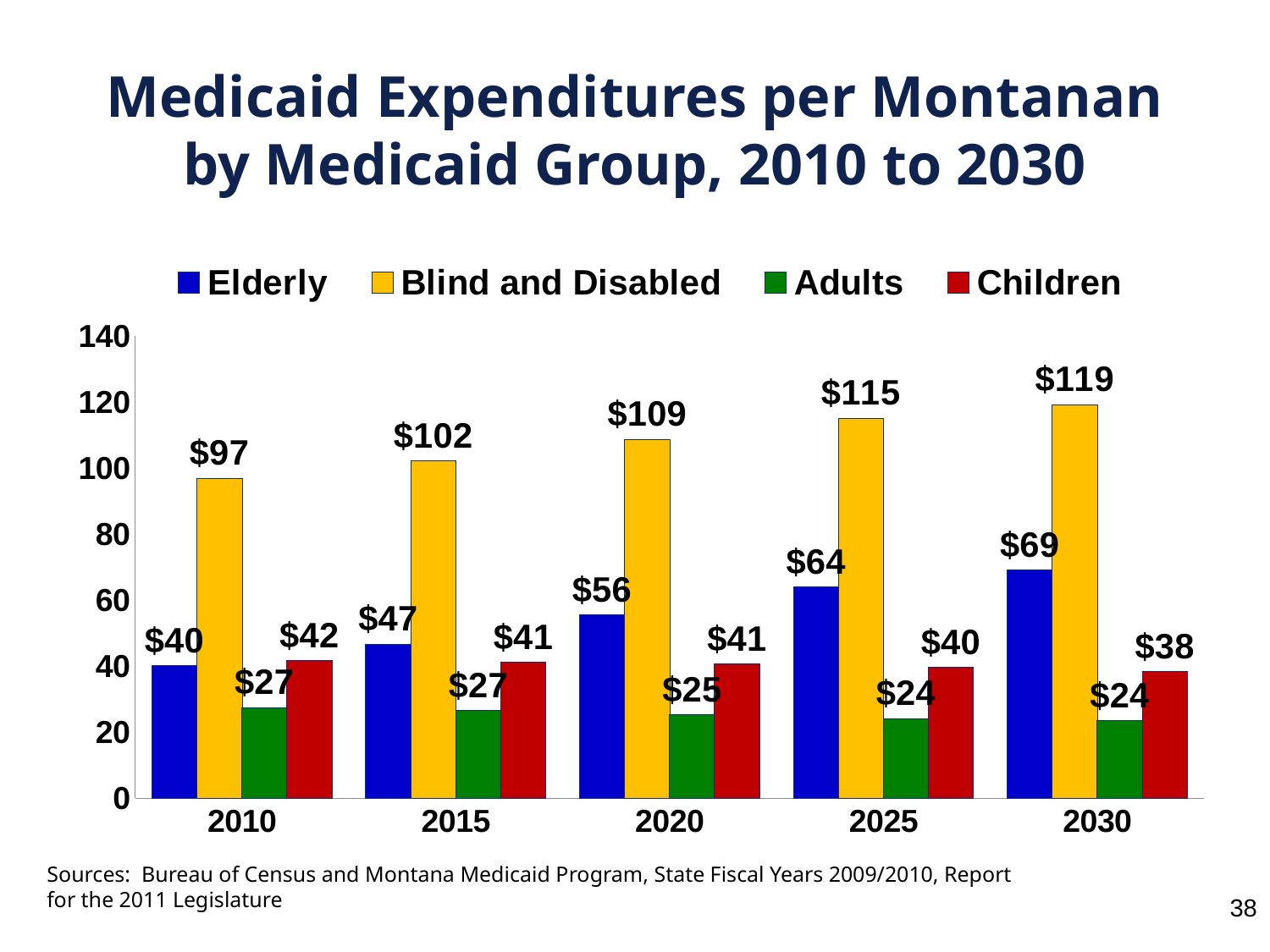
What is the Medicaid expenditure per Montanan for the Blind and Disabled group in 2020? $109 How many years are shown on the x axis? 5 What kind of chart is shown on the slide? Bar chart What is the difference between the Blind and Disabled value in 2030 and in 2010? $22 What is the value for Elderly in 2030? $69 Is the Blind and Disabled value for 2025 greater or less than 100? greater How many series does the legend list? 4 Which is larger in 2015: the Elderly value or the Children value? Elderly What is the value for Children in 2010? $42 In which year is the Blind and Disabled value highest? 2030 In which year is the Adults value lowest? 2025 and 2030 Do the Elderly values rise or fall from 2010 to 2030? Rise